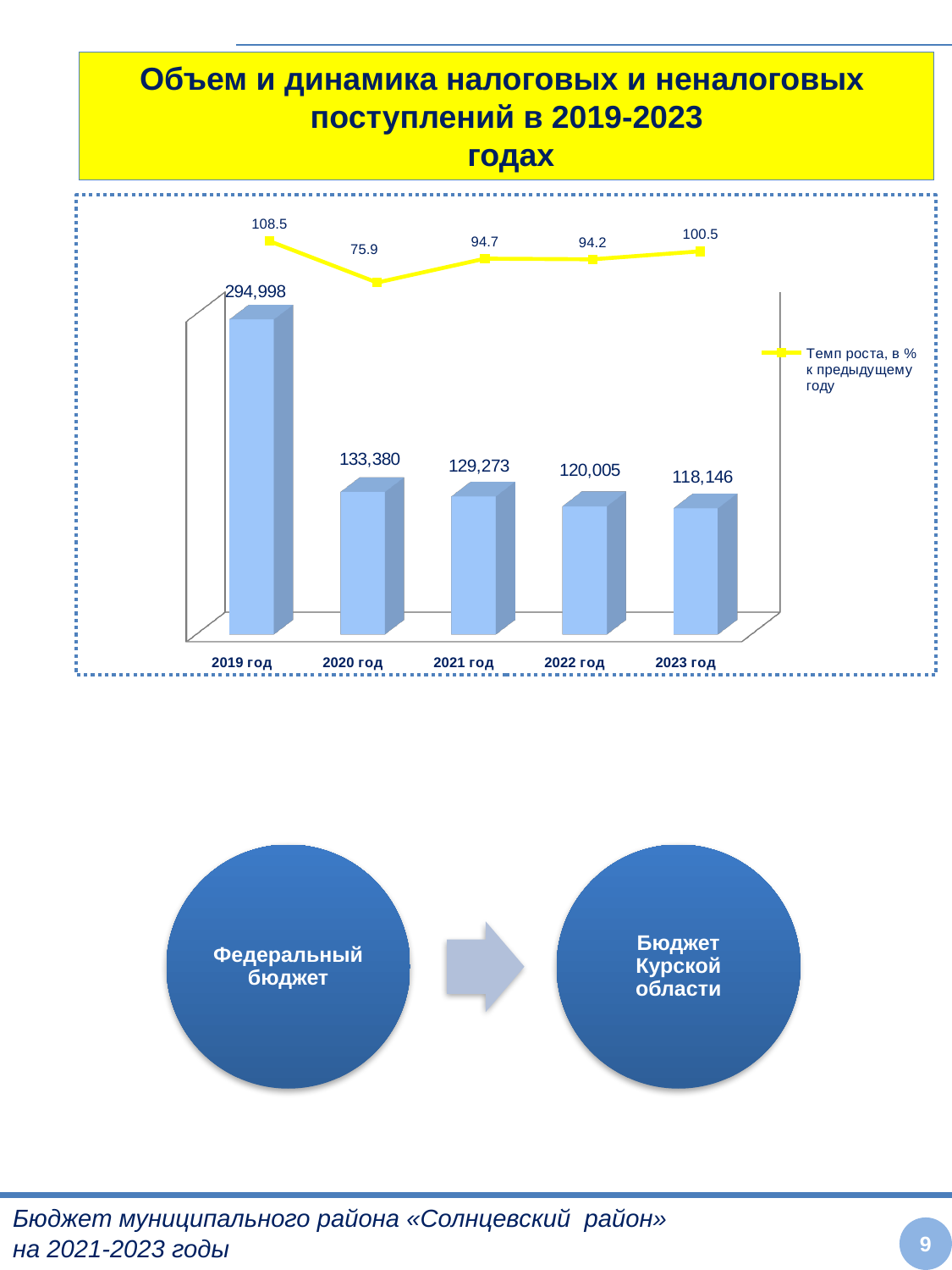
Which is larger, the bar value for 2021 год or for 2022 год? 2021 год What is the difference between the 'Темп роста' values for 2019 год and 2020 год? 32.6 Do the bar values rise or fall from 2019 год to 2023 год? fall What is the difference between the bar values for 2019 год and 2020 год? 161,618 What is the value of the 'Темп роста' line for 2023 год? 100.5 How many entries does the chart legend list? 1 What is the bar value for 2019 год? 294,998 What is the value of the 'Темп роста' line for 2020 год? 75.9 Which year has the highest bar value? 2019 год How many years are shown on the x axis of the chart? 5 Which year has the lowest value on the 'Темп роста' line? 2020 год What is the bar value for 2023 год? 118,146